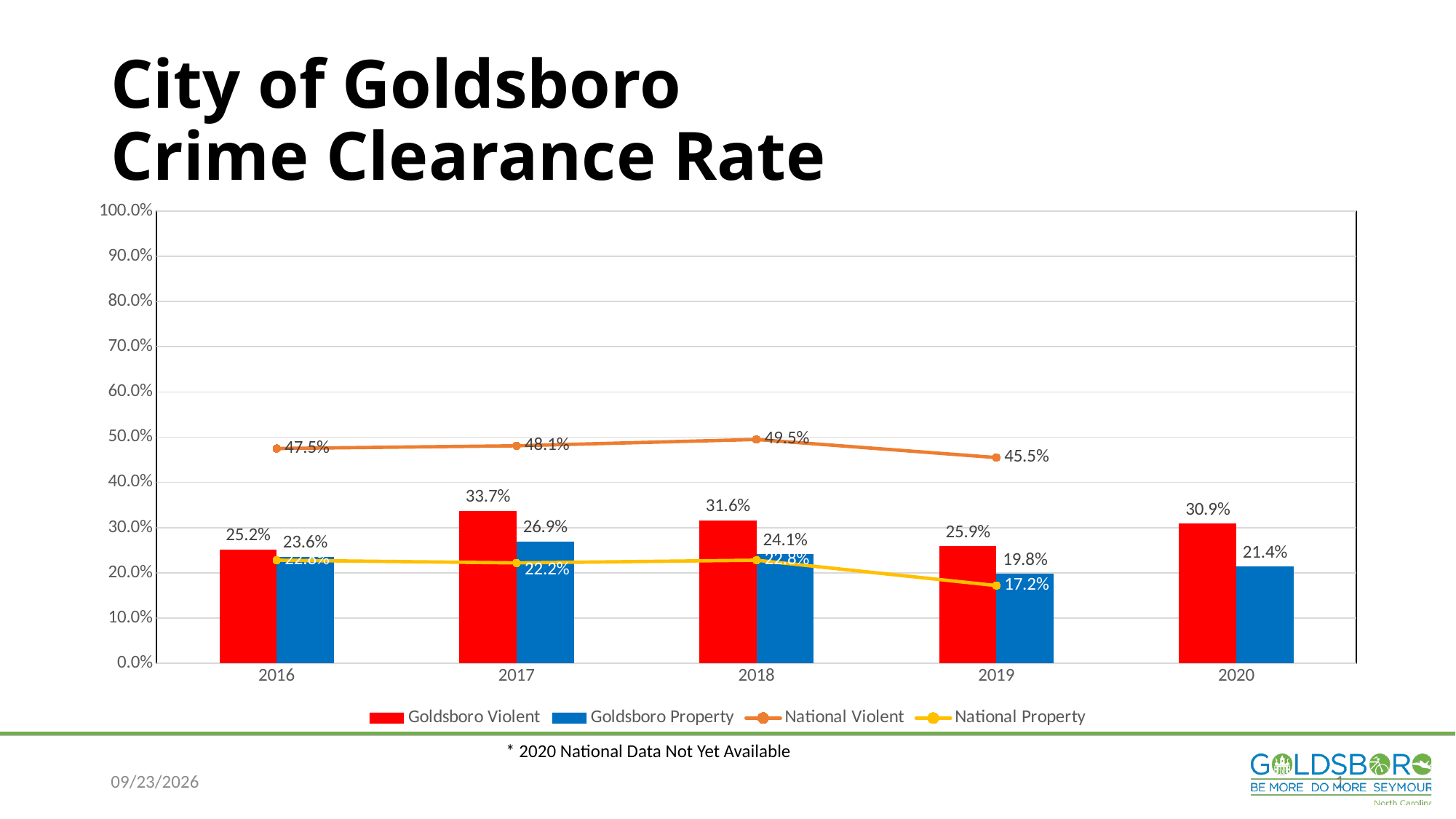
In which year is the National Violent clearance rate highest? 2018 What kind of chart is this? Combination bar and line chart In which year is the Goldsboro Property clearance rate lowest? 2019 How many series does the legend list? 4 Which is larger, the National Violent clearance rate in 2016 or in 2019? 2016 What is the National Violent clearance rate for 2018? 49.5% What is the difference between the Goldsboro Violent and Goldsboro Property clearance rates in 2020? 9.5 percentage points Does the National Violent clearance rate rise or fall from 2018 to 2019? Fall What is the Goldsboro Violent clearance rate for 2017? 33.7% What is the National Property clearance rate for 2019? 17.2% How many years are shown on the x axis? 5 In which year is the Goldsboro Violent clearance rate highest? 2017